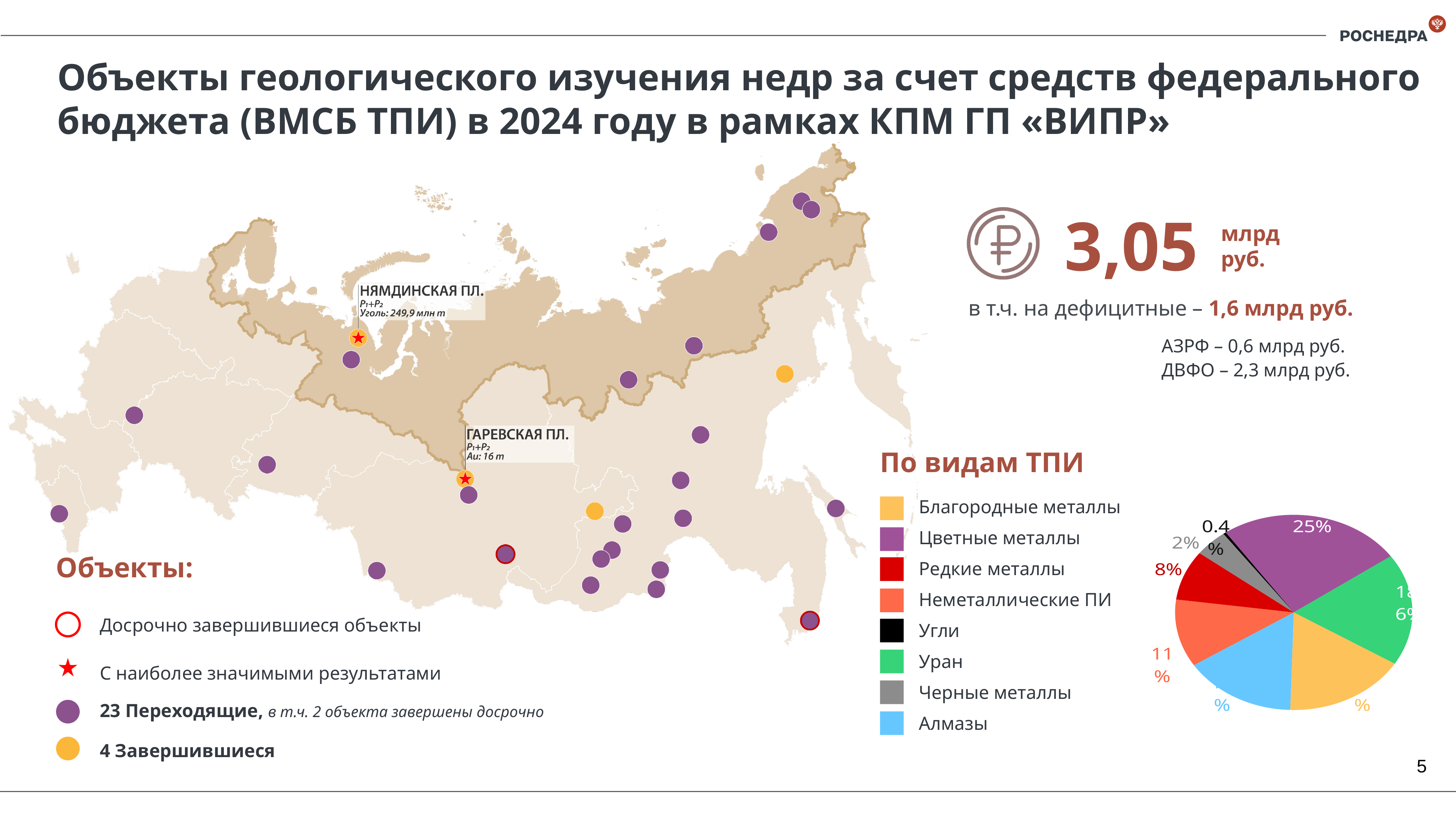
In the pie chart "По видам ТПИ", what is the difference between the shares for Цветные металлы and Редкие металлы? 17% In the pie chart "По видам ТПИ", what share is shown for Цветные металлы? 25% In the pie chart "По видам ТПИ", which category has the largest slice? Цветные металлы In the pie chart "По видам ТПИ", what share is shown for Угли? 0.4% In the pie chart "По видам ТПИ", what colour represents Уран? green In the pie chart "По видам ТПИ", what share is shown for Редкие металлы? 8% In the pie chart "По видам ТПИ", which category has the smallest slice? Угли What kind of chart is shown under the heading "По видам ТПИ"? pie chart In the pie chart "По видам ТПИ", what share is shown for Неметаллические ПИ? 11% In the pie chart "По видам ТПИ", what share is shown for Черные металлы? 2% In the pie chart "По видам ТПИ", which is larger: the share for Редкие металлы or for Черные металлы? Редкие металлы How many categories does the legend of the pie chart "По видам ТПИ" list? 8